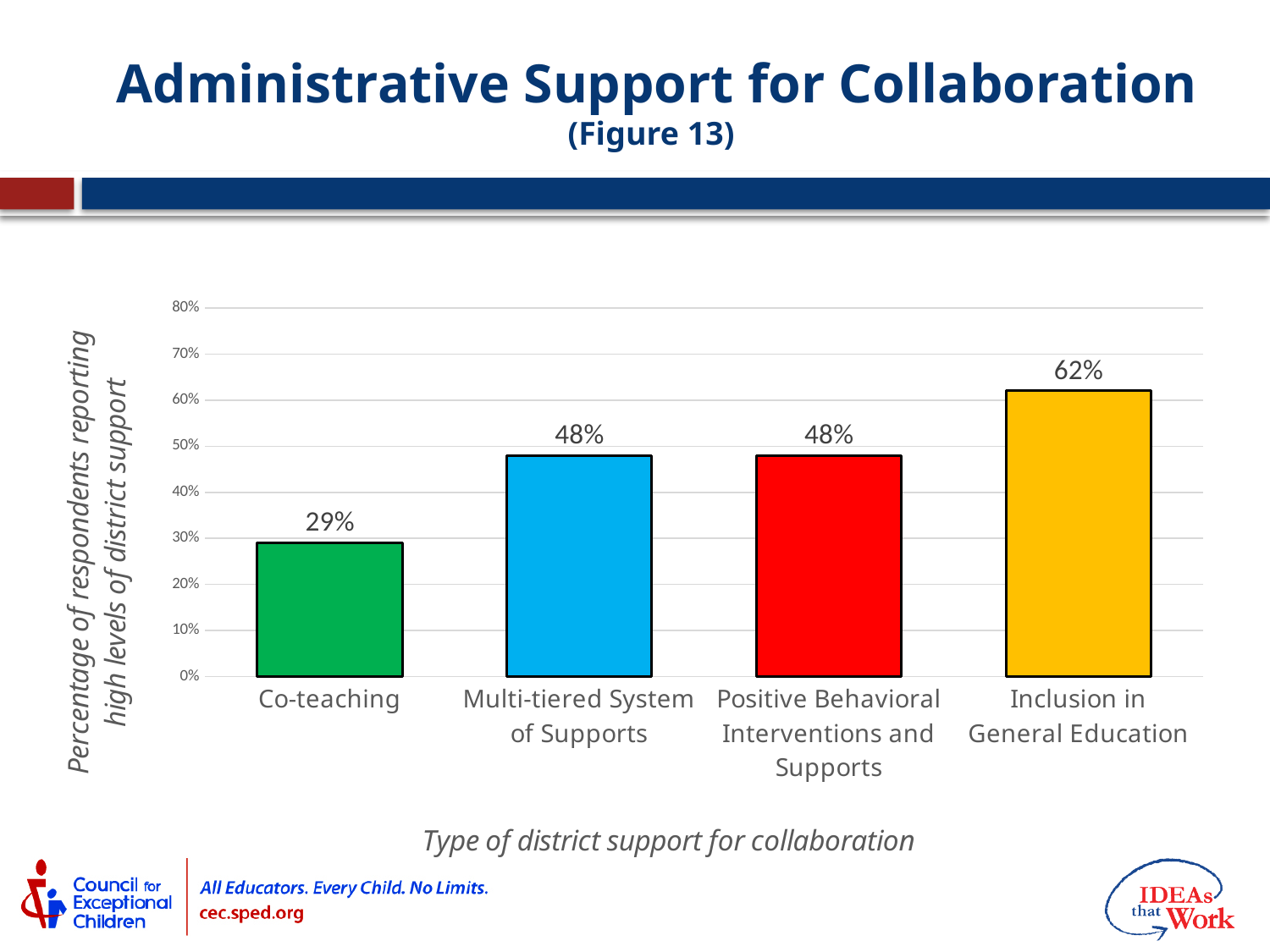
What kind of chart is shown on the slide? Bar chart Which type of district support has the lowest percentage? Co-teaching What percentage of respondents reported high levels of district support for Co-teaching? 29% What is the value shown for Inclusion in General Education? 62% What is the x-axis title of the chart? Type of district support for collaboration What is the difference between the values for Inclusion in General Education and Co-teaching? 33% Which is larger, the value for Co-teaching or the value for Inclusion in General Education? Inclusion in General Education Is the value for Inclusion in General Education greater or less than 60%? greater How many types of district support are shown on the chart? 4 What is the value shown for Multi-tiered System of Supports? 48% What is the difference between the values for Positive Behavioral Interventions and Supports and Co-teaching? 19% Which type of district support has the highest percentage? Inclusion in General Education